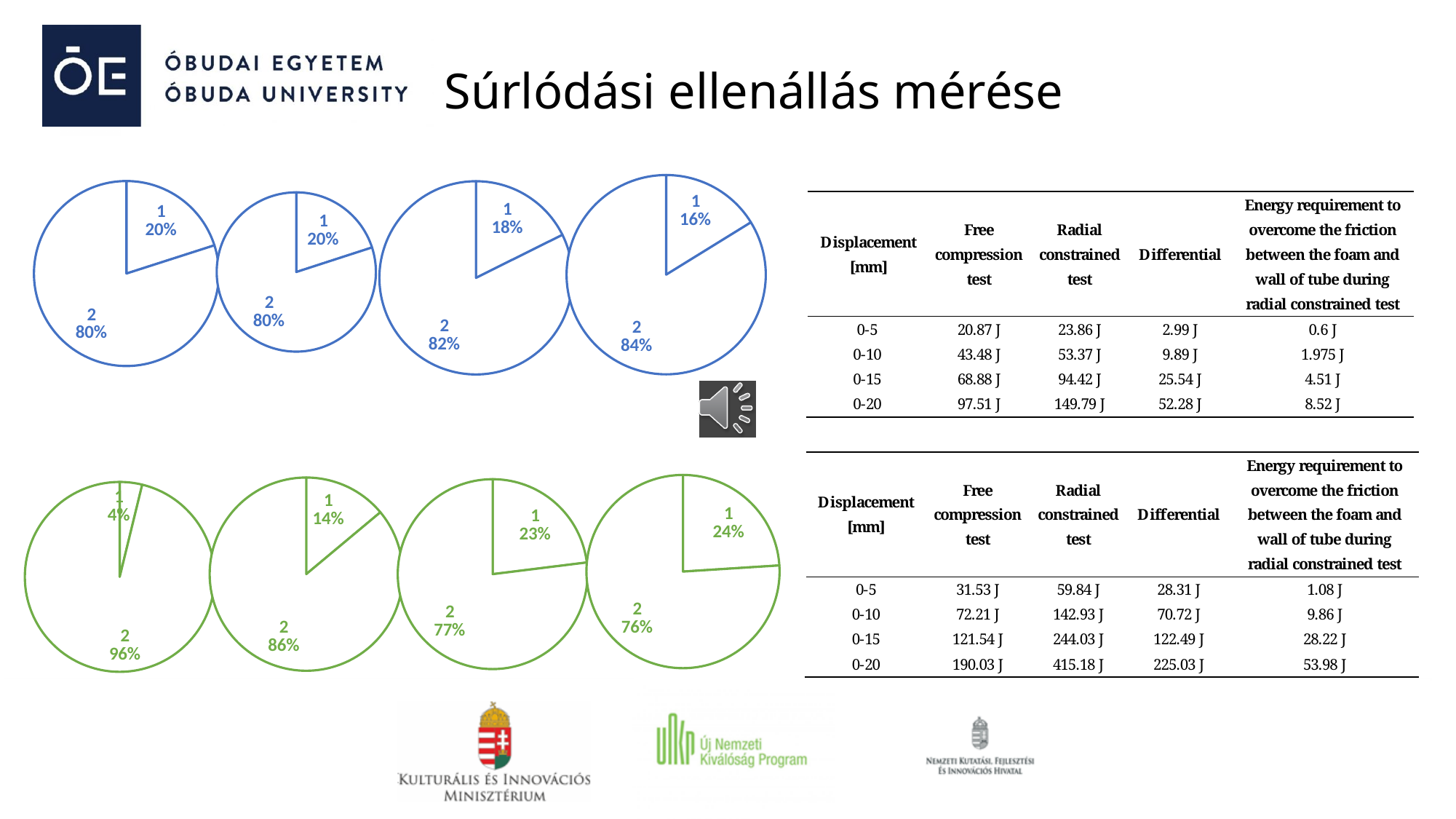
In the third blue pie chart in the top row, what is the value shown for slice 1? 18% In the first (leftmost) blue pie chart in the top row, what share does slice 1 have? 20% What colour are the pie charts in the bottom row? Green In the third green pie chart in the bottom row, which slice is larger, 1 or 2? 2 In the first (leftmost) green pie chart in the bottom row, what share does slice 1 have? 4% In the fourth (rightmost) blue pie chart in the top row, what is the difference between the shares of slice 2 and slice 1? 68% In the fourth (rightmost) blue pie chart in the top row, what share does slice 2 have? 84% In the first (leftmost) green pie chart in the bottom row, what is the difference between the shares of slice 2 and slice 1? 92% What type of chart is used in the top row of the slide? Pie chart In the second green pie chart in the bottom row, what is the value shown for slice 2? 86% How many slices does each pie chart on the slide have? 2